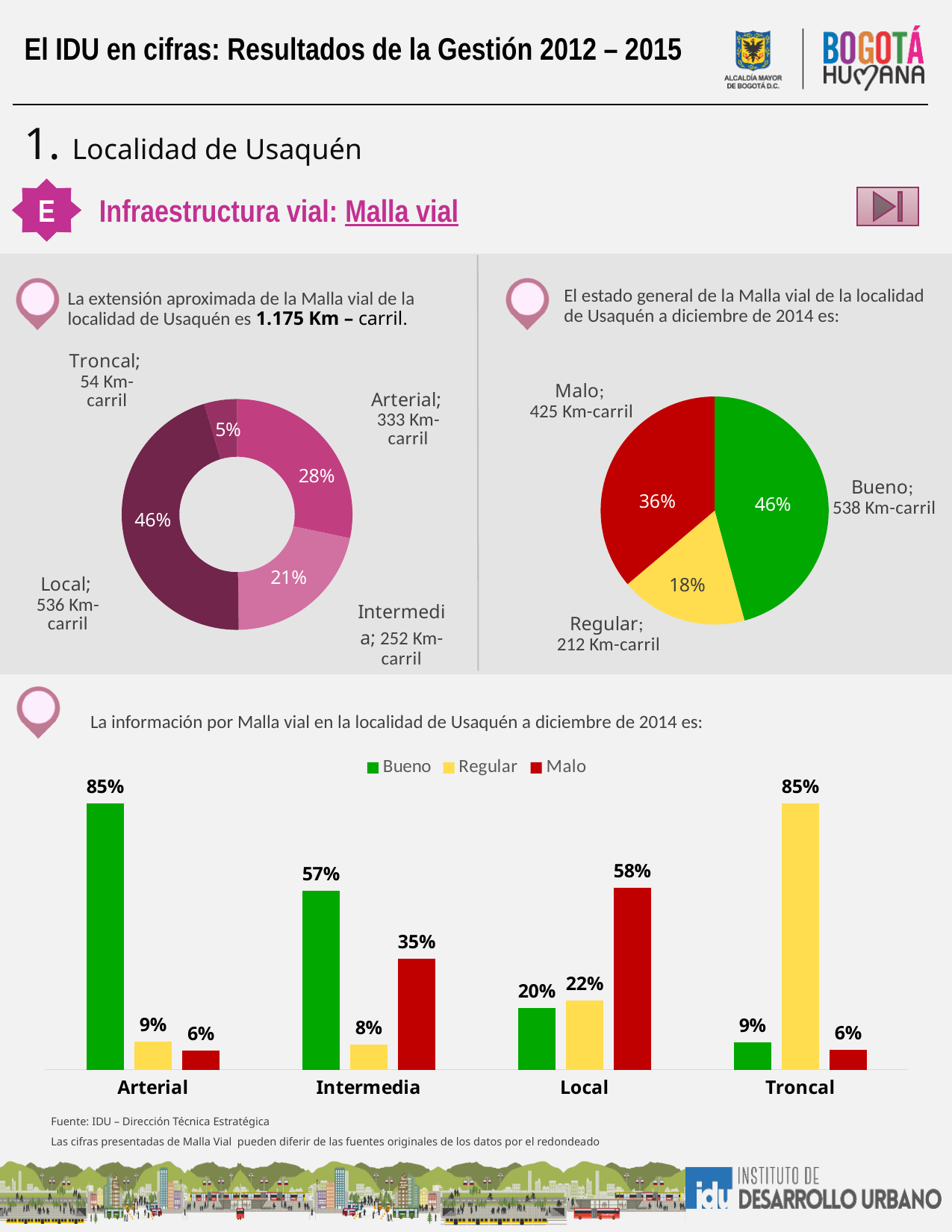
In the top-left donut chart, what share does Local represent? 46% In the top-right pie chart, what share is Malo? 36% In the bottom bar chart, what is the Malo value for Local? 58% In the bottom bar chart, what is the difference between the Bueno values for Arterial and Intermedia? 28% In the top-right pie chart, which category has the largest share? Bueno In the top-left donut chart, which category has the smallest share? Troncal What type of chart is the bottom chart on the slide? Bar chart How many categories does the top-left donut chart show? 4 In the bottom bar chart, which is larger for Troncal: Bueno or Malo? Bueno In the top-left donut chart, how many Km-carril does Arterial have? 333 Km-carril How many series does the legend of the bottom bar chart list? 3 In the top-right pie chart, how many Km-carril are in Regular state? 212 Km-carril